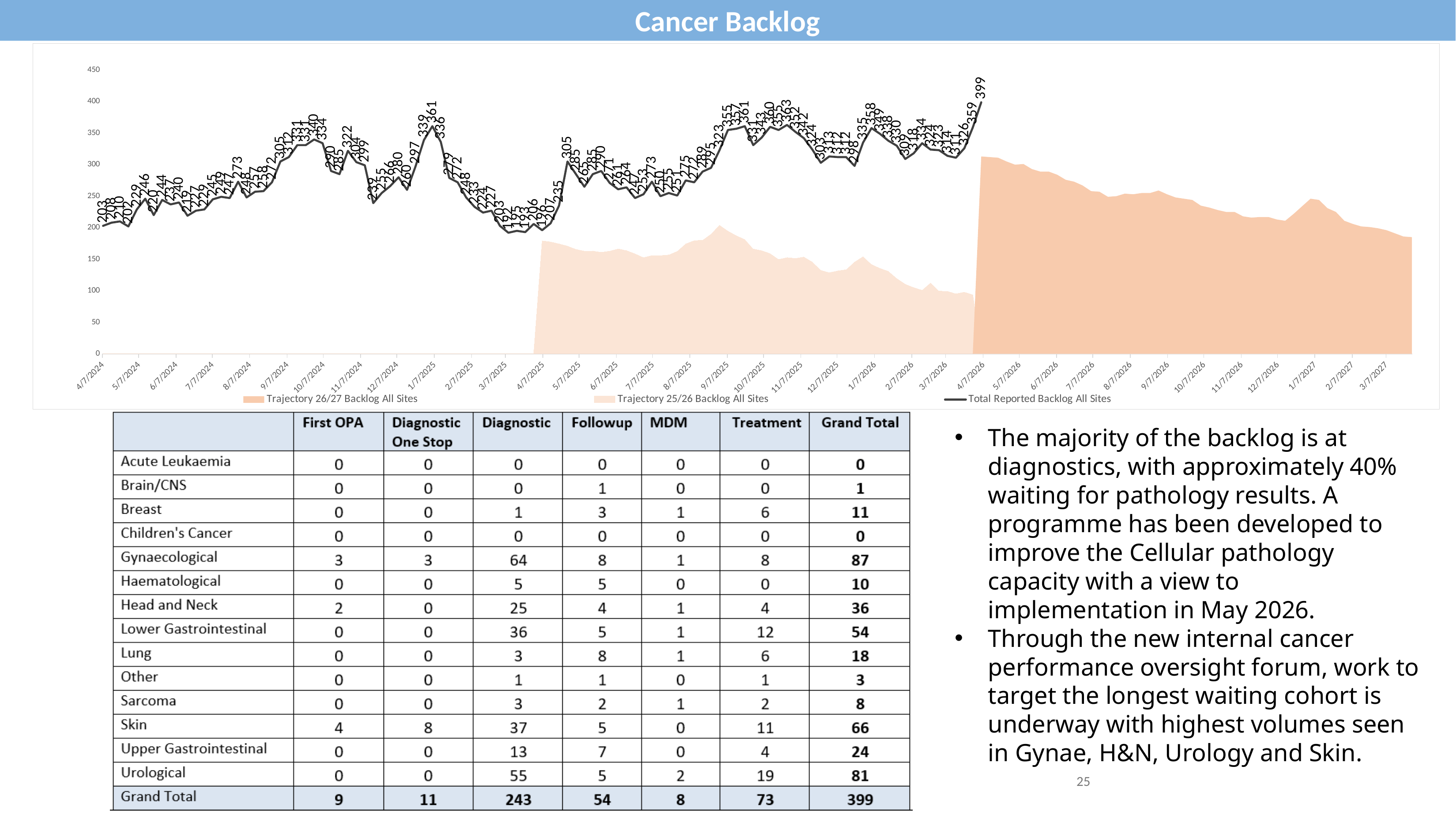
Which series is drawn as a black line in the chart? Total Reported Backlog All Sites What is the highest value shown on the chart's vertical axis? 450 Is the Trajectory 26/27 Backlog All Sites value at 3/7/2027 greater or less than 250? less What is the highest labelled value of the Total Reported Backlog All Sites series? 399 What is the value of the Total Reported Backlog All Sites series at the first point, 4/7/2024? 203 At 4/7/2026, which is higher: the Trajectory 26/27 Backlog All Sites or the Trajectory 25/26 Backlog All Sites? Trajectory 26/27 Backlog All Sites How many series does the chart legend list? 3 What is the difference between the Total Reported Backlog value of 399 at 4/7/2026 and the peak of 361 at 1/7/2025? 38 What is the value of the Total Reported Backlog All Sites series at 4/7/2026, the last labelled point? 399 Does the Trajectory 26/27 Backlog All Sites series generally rise or fall from 4/7/2026 to 3/7/2027? fall Which is larger: the Total Reported Backlog at 4/7/2026 (399) or the peak at 1/7/2025 (361)? 4/7/2026 (399) Is the Total Reported Backlog All Sites value at 4/7/2026 greater or less than 350? greater